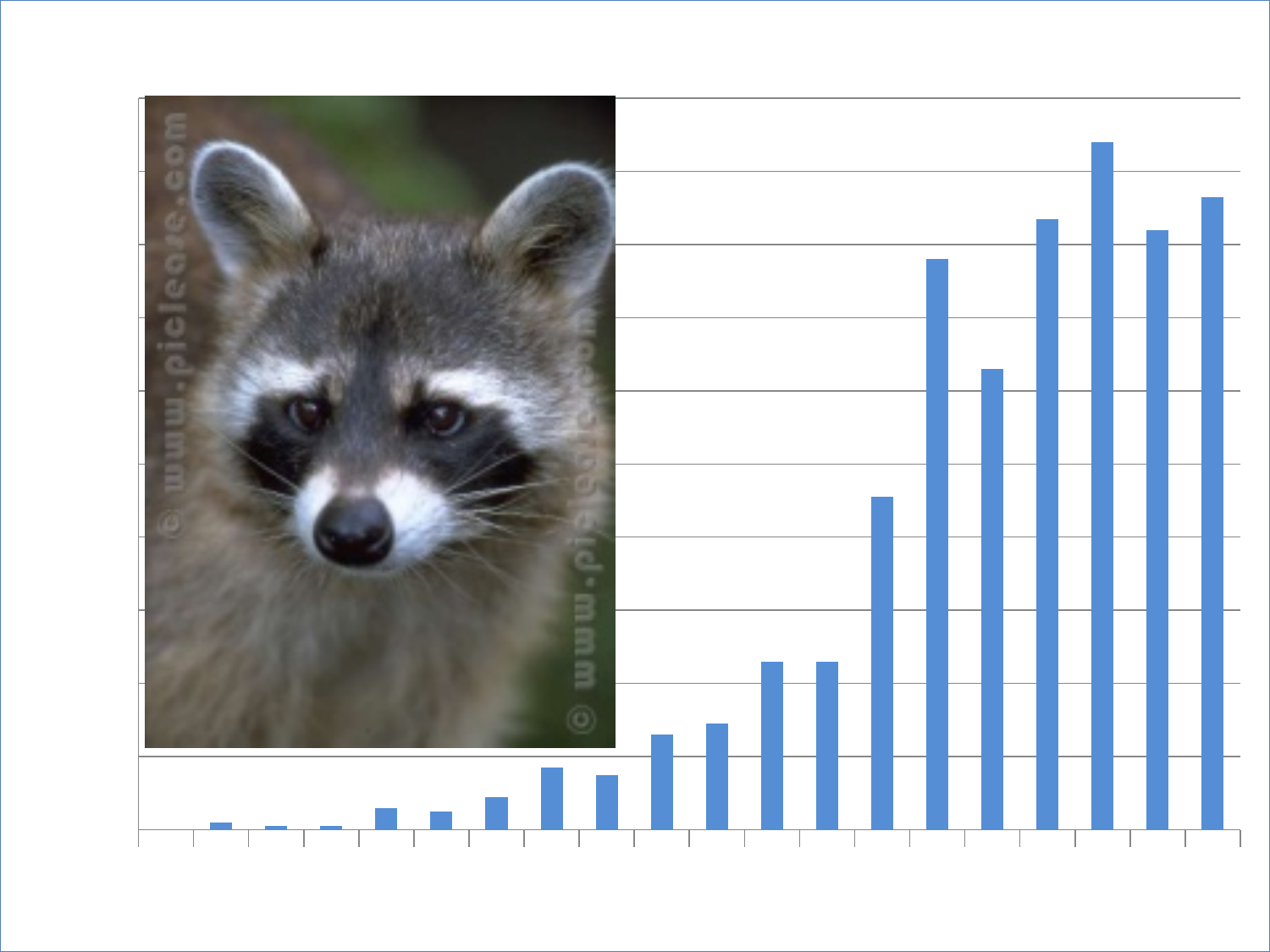
What kind of chart is shown on the slide? bar chart Do the bar values generally rise or fall from left to right along the x axis? rise Are the bars in the chart vertical or horizontal? vertical Is the rightmost bar taller or shorter than the leftmost visible bar? taller Are the shortest bars in the left half or the right half of the chart? left half Is the tallest bar in the left half or the right half of the chart? right half What colour are the bars in the chart? blue Is the rightmost bar taller or shorter than the tallest bar in the chart? shorter